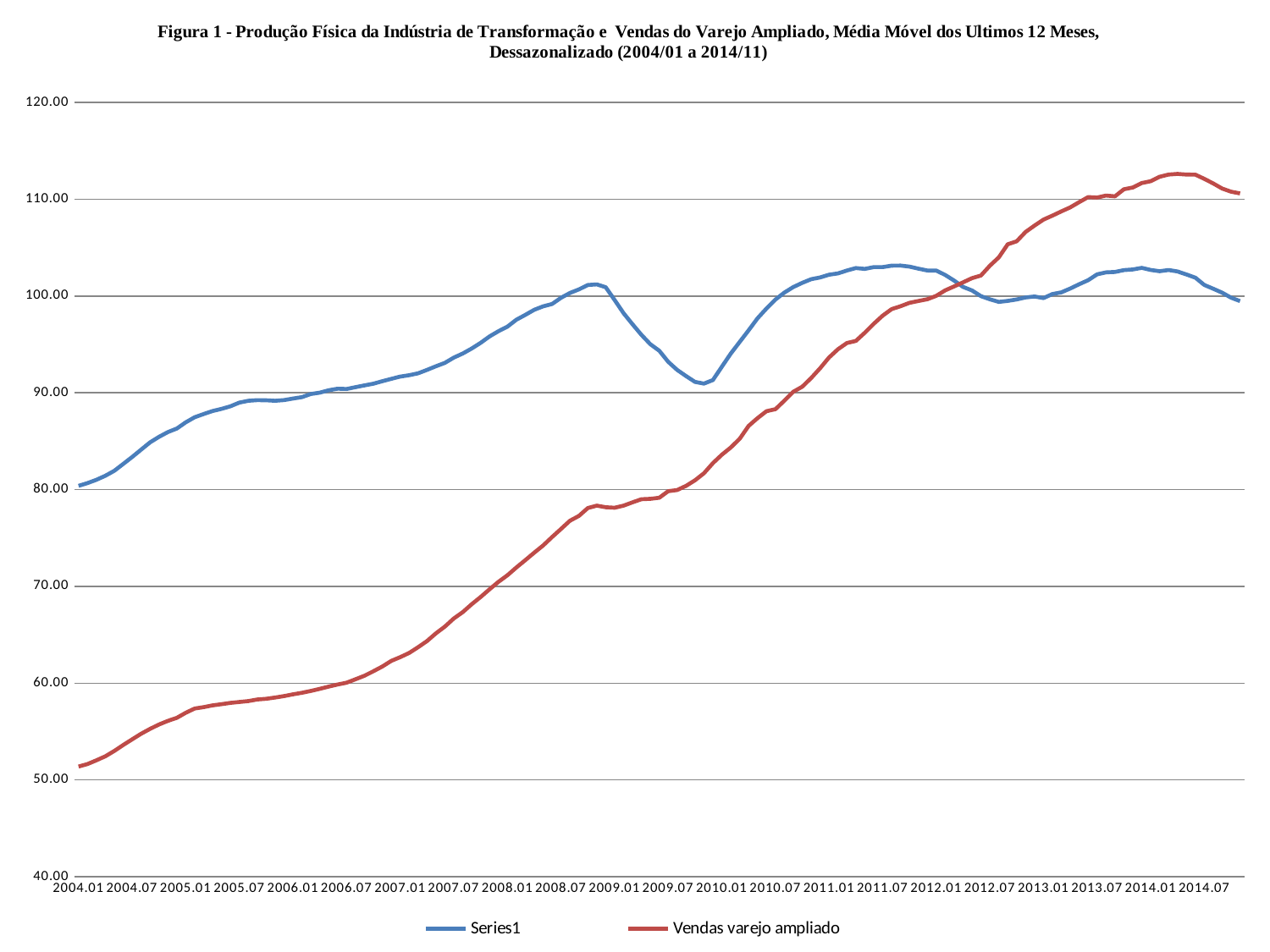
Is the value of Vendas varejo ampliado at 2004.01 greater or less than 60? less At 2014.07, which series has the higher value, Series1 or Vendas varejo ampliado? Vendas varejo ampliado Is the value of Series1 at 2005.01 greater or less than 90? less At 2009.01, which series has the higher value, Series1 or Vendas varejo ampliado? Series1 At which x-axis point does the Vendas varejo ampliado series reach its lowest value? 2004.01 Does the Vendas varejo ampliado series generally rise or fall from 2004.01 to 2014.01? rise What are the names of the two series in the legend? Series1 and Vendas varejo ampliado Is the value of Vendas varejo ampliado at 2014.01 greater or less than 110? greater What type of chart is shown on the slide? line chart Which series is drawn in red? Vendas varejo ampliado How many series does the legend list? 2